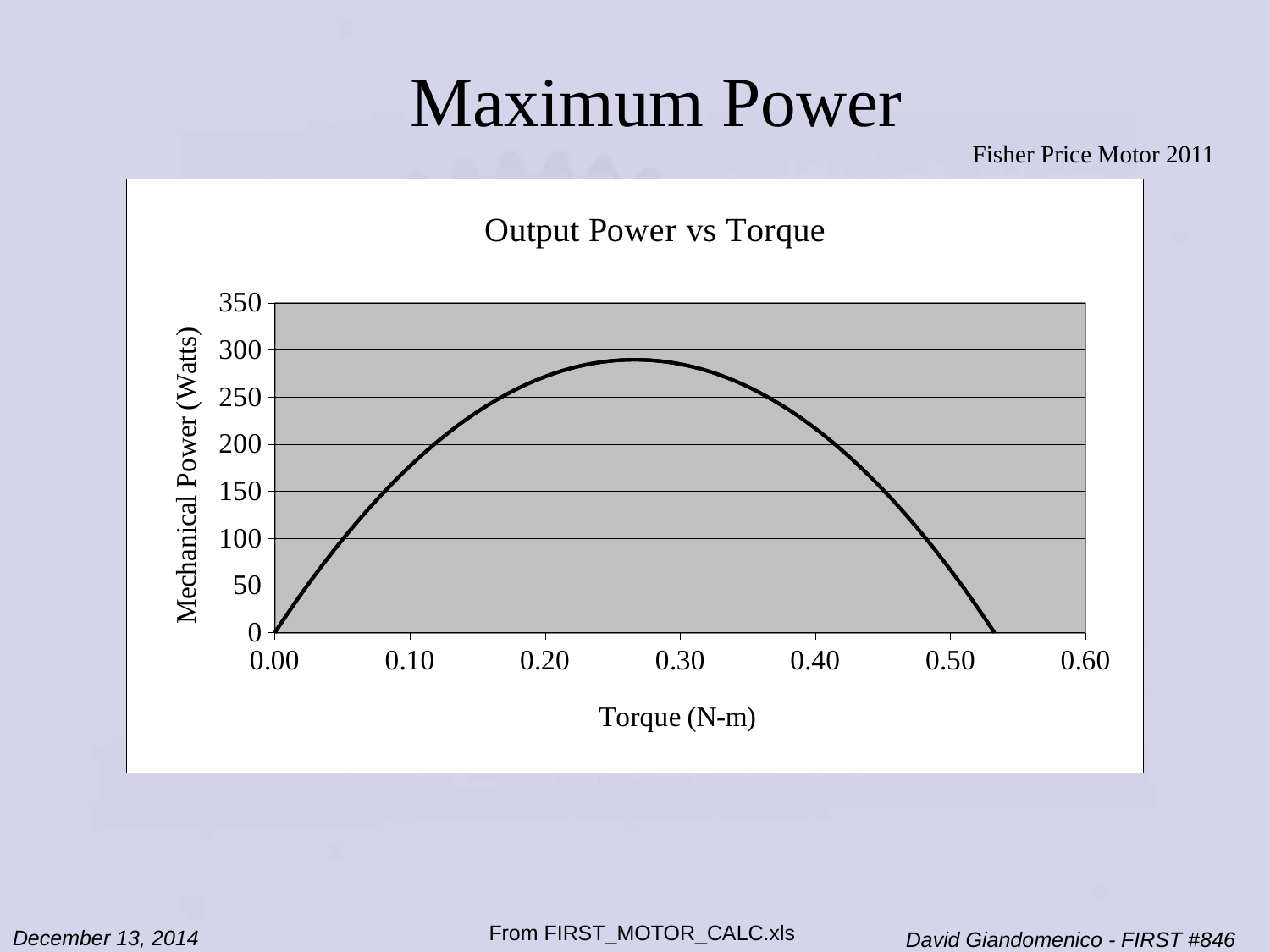
What is the mechanical power at a torque of 0.00 N-m? 0 What is the label of the vertical axis? Mechanical Power (Watts) Is the mechanical power at a torque of 0.10 N-m greater or less than 150? greater What is the highest value shown on the vertical axis? 350 What is the title of the chart? Output Power vs Torque Is the peak mechanical power on the curve greater or less than 300? less Is the mechanical power at a torque of 0.50 N-m greater or less than 150? less Which torque gives the higher mechanical power, 0.20 N-m or 0.50 N-m? 0.20 N-m What kind of chart is shown on the slide? line chart How does mechanical power change as torque increases from 0.00 to 0.60 N-m? rises then falls